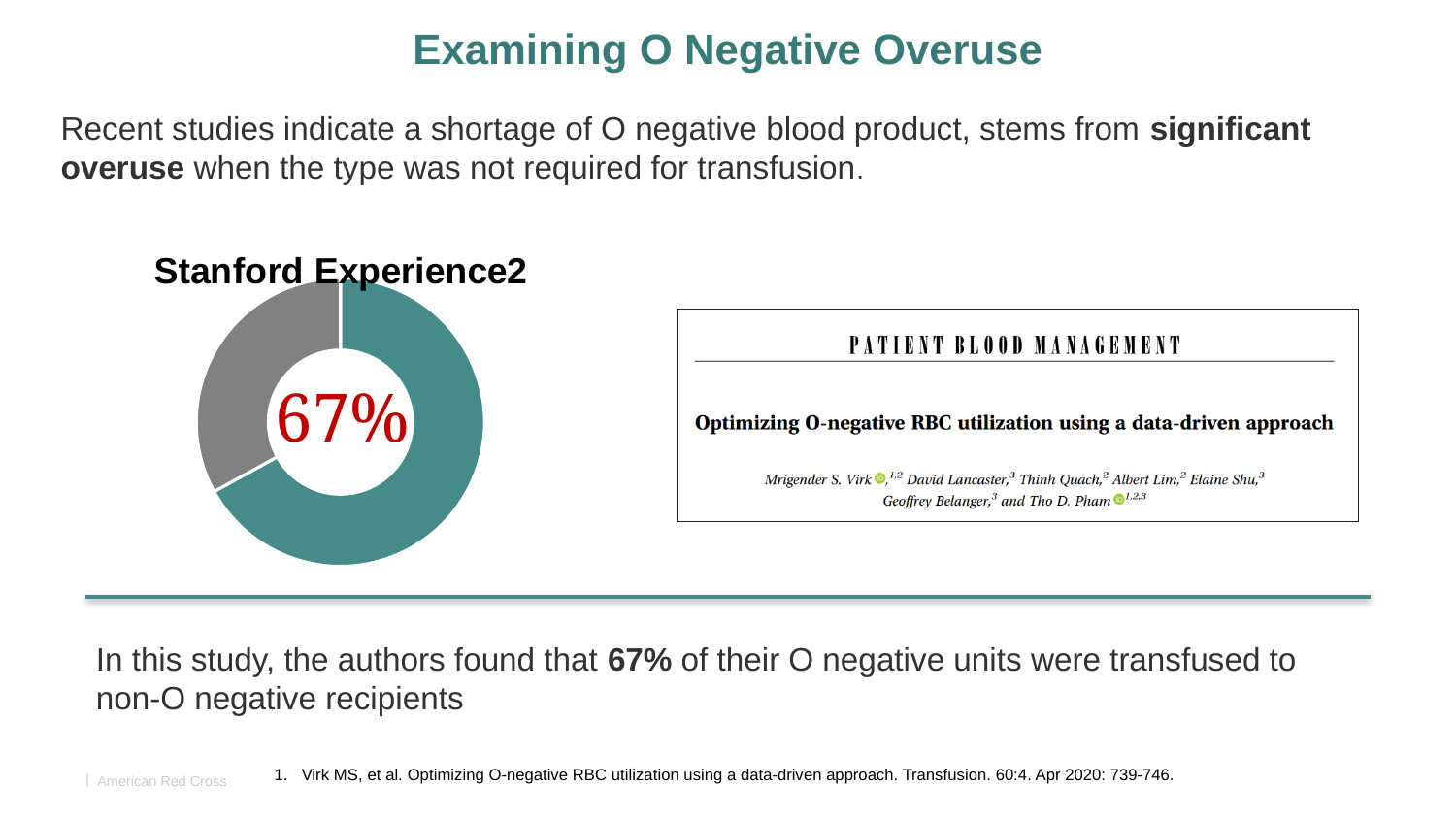
Which slice of the donut chart is larger, the teal one or the gray one? teal What share of the donut chart does the teal slice represent? 67% What is the title shown above the donut chart? Stanford Experience2 How many slices does the donut chart have? 2 What share of the donut chart does the gray slice represent? 33% What kind of chart is shown under the heading "Stanford Experience2"? donut chart Is the share of the teal slice in the donut chart greater or less than 50%? greater What value is printed in the center of the donut chart? 67% What two colours are used for the slices of the donut chart? teal and gray